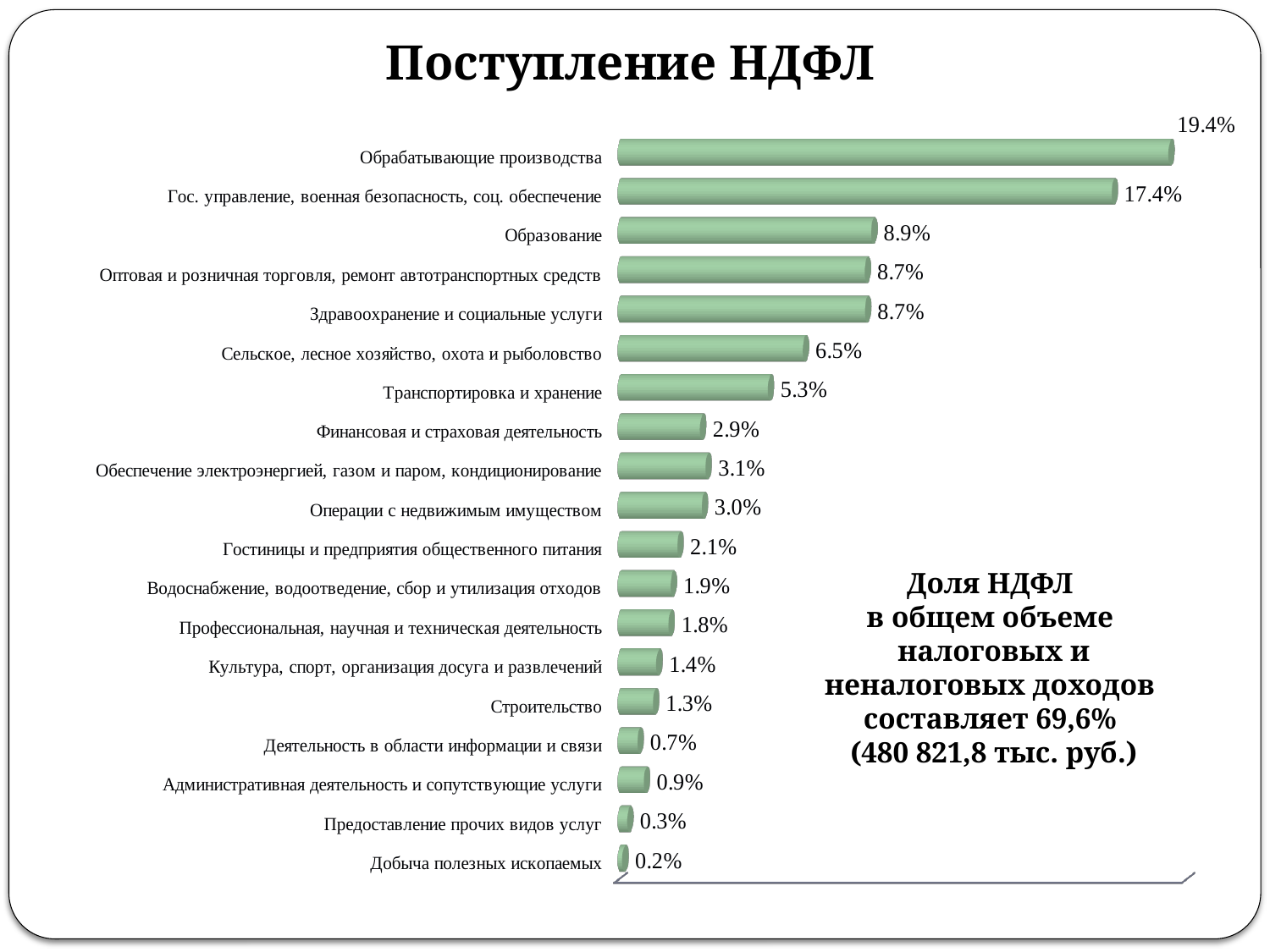
What is the value for Образование? 8.9% What kind of chart is shown on the slide? Bar chart Which category has the highest value? Обрабатывающие производства Which is larger: the value for Сельское, лесное хозяйство, охота и рыболовство or the value for Транспортировка и хранение? Сельское, лесное хозяйство, охота и рыболовство How many categories are shown in the chart? 19 Which category has the lowest value? Добыча полезных ископаемых What is the value for Строительство? 1.3% What is the title of the slide? Поступление НДФЛ What is the value for Гостиницы и предприятия общественного питания? 2.1% What is the difference between the values for Обеспечение электроэнергией, газом и паром, кондиционирование and Финансовая и страховая деятельность? 0.2% What is the value for Транспортировка и хранение? 5.3% What is the difference between the values for Обрабатывающие производства and Гос. управление, военная безопасность, соц. обеспечение? 2.0%